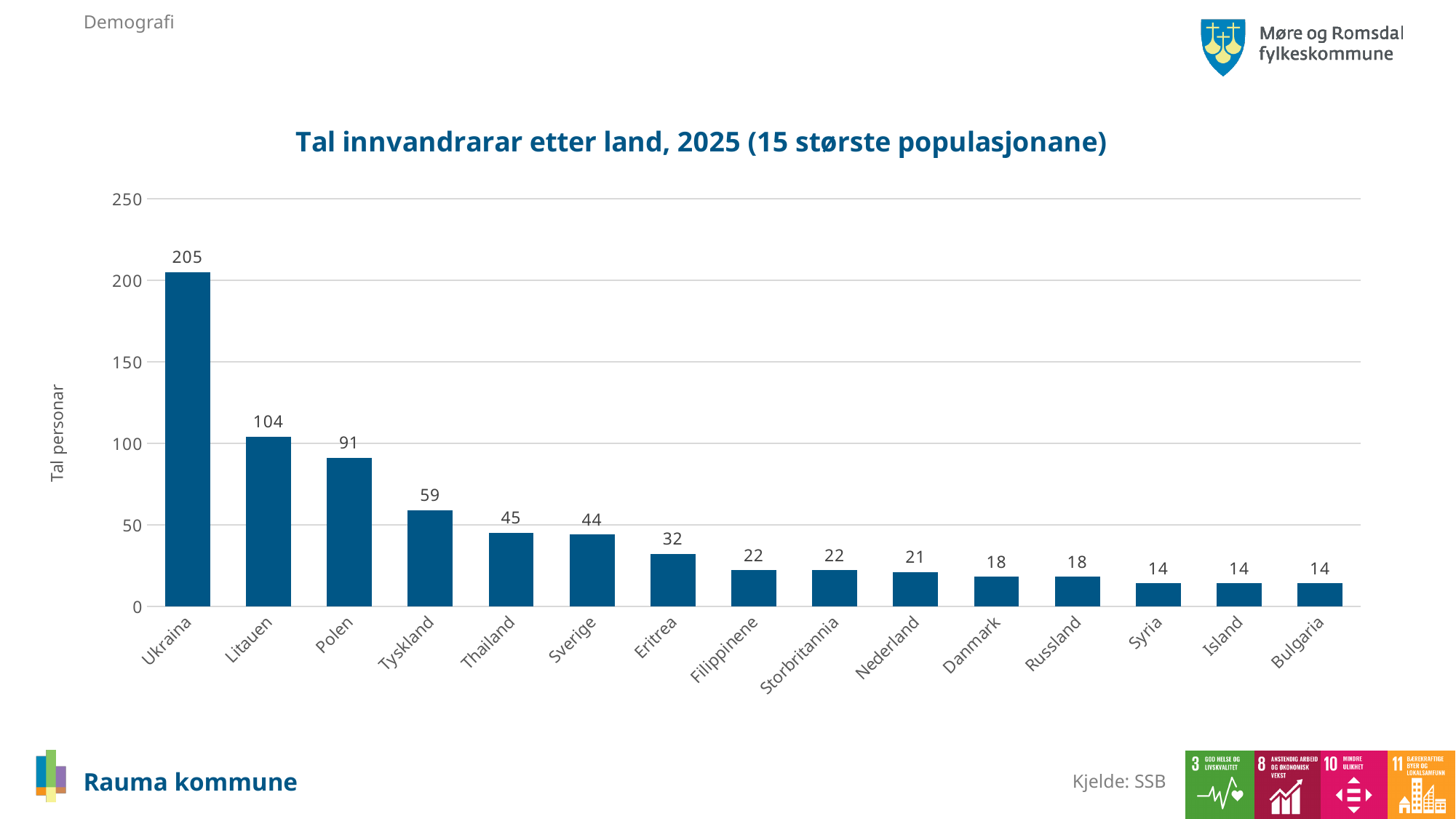
What is the difference between the values for Litauen and Polen? 13 What is the title of the chart? Tal innvandrarar etter land, 2025 (15 største populasjonane) What is the difference between the values for Ukraina and Litauen? 101 Which country has the highest value? Ukraina Is the value for Polen greater or less than 100? less What is the value for Eritrea? 32 How many countries are shown on the chart? 15 What kind of chart is shown on the slide? bar chart What is the value for Ukraina? 205 Which is larger, the value for Thailand or the value for Eritrea? Thailand What is the value for Tyskland? 59 Do the values rise or fall from left to right along the x axis? fall